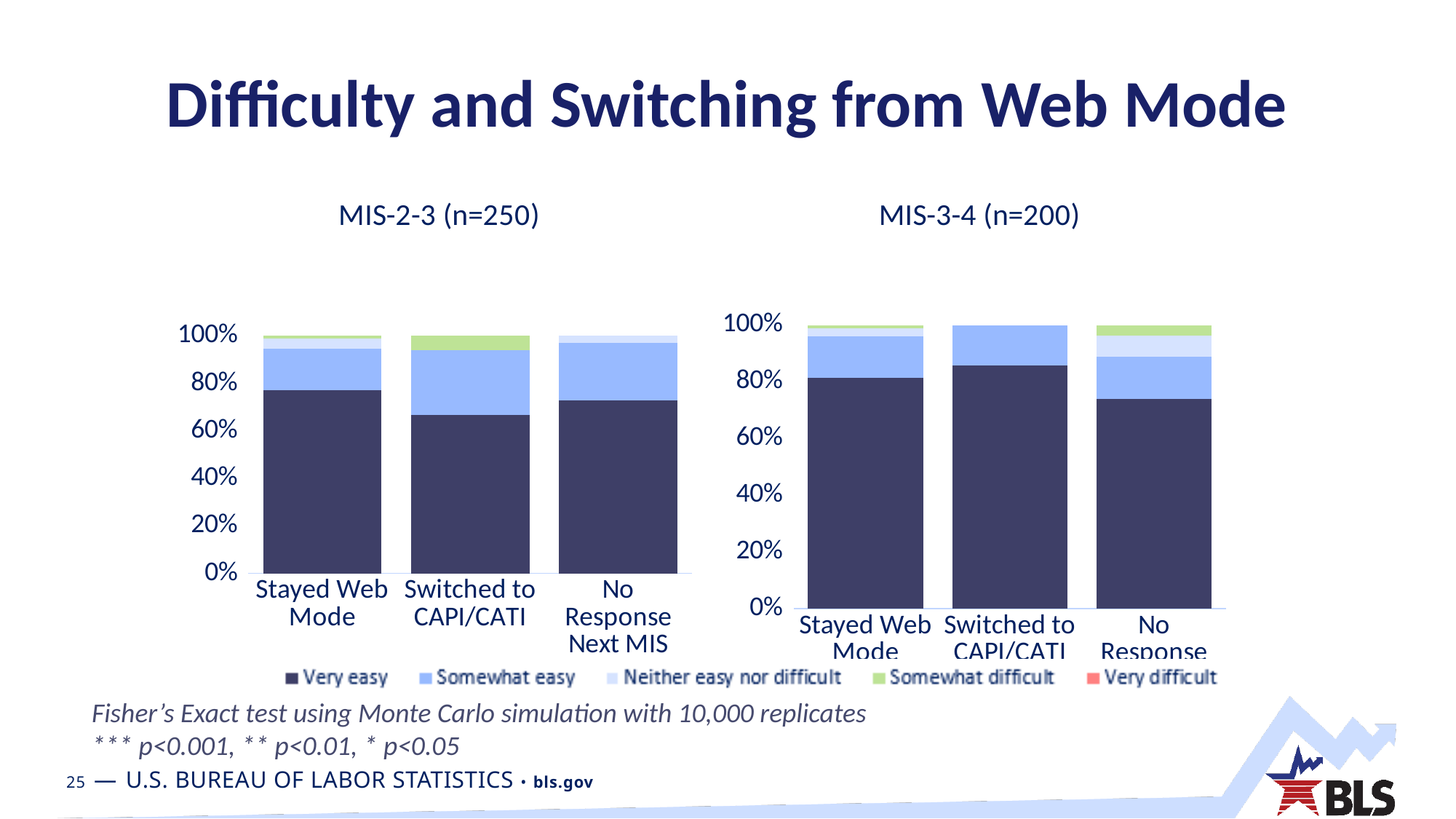
Which legend entry is shown in green? Somewhat difficult In the MIS-3-4 (n=200) chart, is the Very easy value for Switched to CAPI/CATI greater or less than 80%? greater How many series does the legend list? 5 What kind of chart is the MIS-2-3 (n=250) chart? stacked bar chart In the MIS-2-3 (n=250) chart, which category has the lowest Very easy share? Switched to CAPI/CATI In the MIS-2-3 (n=250) chart, is the Very easy value for Stayed Web Mode greater or less than 60%? greater In the MIS-2-3 (n=250) chart, is the Very easy value for Switched to CAPI/CATI greater or less than 80%? less What is the sample size shown in the title of the right-hand chart? n=200 How many categories are shown on the x axis of the MIS-3-4 (n=200) chart? 3 In the MIS-2-3 (n=250) chart, is the Very easy share larger for Stayed Web Mode or for Switched to CAPI/CATI? Stayed Web Mode In the MIS-3-4 (n=200) chart, which category has the highest Very easy share? Switched to CAPI/CATI